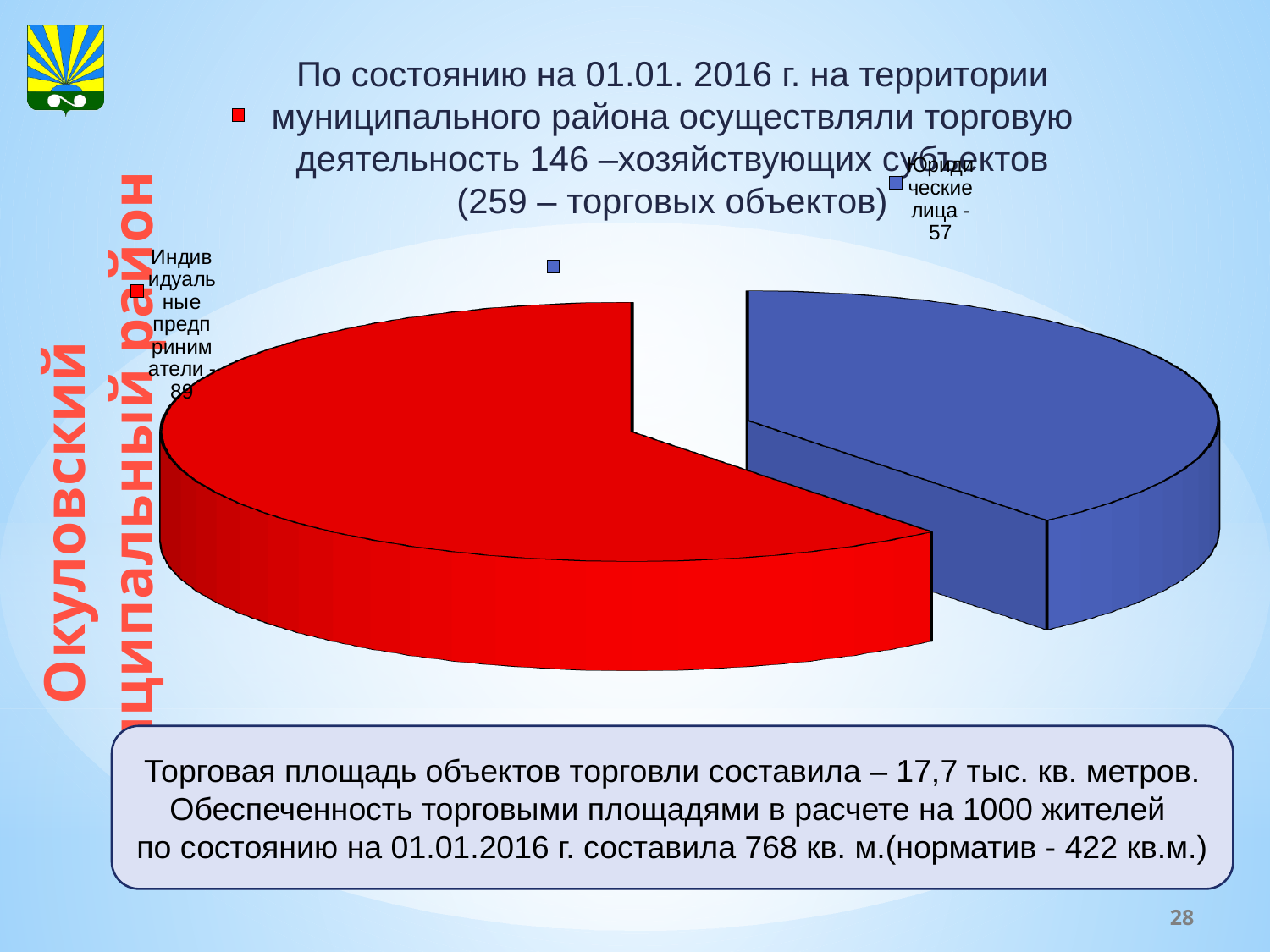
What colour is the slice for Юридические лица? blue What value is shown for Юридические лица in the pie chart? 57 Which category has the smallest slice in the pie chart? Юридические лица What is the difference between the values for Индивидуальные предприниматели and Юридические лица? 32 What colour is the slice for Индивидуальные предприниматели? red What kind of chart is shown on the slide? pie chart Which category has the largest slice in the pie chart? Индивидуальные предприниматели How many slices does the pie chart have? 2 What share of the pie does the Индивидуальные предприниматели slice represent? 61% Which is larger: the value for Индивидуальные предприниматели or for Юридические лица? Индивидуальные предприниматели What is the total of the two values shown in the pie chart? 146 What value is shown for Индивидуальные предприниматели in the pie chart? 89